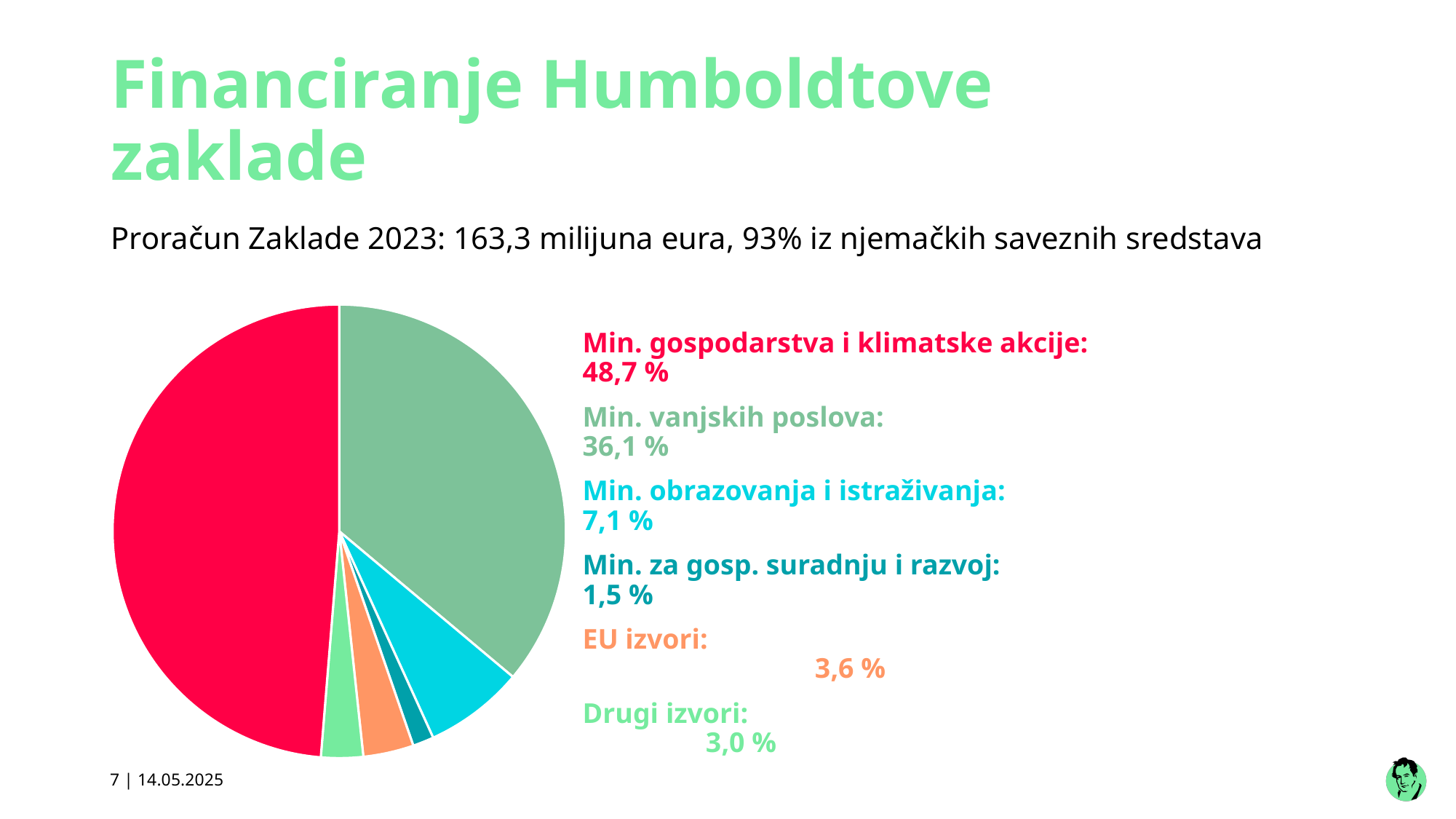
How many slices does the pie chart have? 6 What percentage is listed for Min. obrazovanja i istraživanja? 7,1 % What is the value for EU izvori? 3,6 % What share of the pie does Min. gospodarstva i klimatske akcije hold? 48,7 % Which category has the smallest slice of the pie? Min. za gosp. suradnju i razvoj What is the difference between the shares of Min. gospodarstva i klimatske akcije and Min. vanjskih poslova? 12,6 % What colour is the slice for Min. obrazovanja i istraživanja? Cyan Which is larger, the share for EU izvori or the share for Drugi izvori? EU izvori What type of chart is shown on the slide? Pie chart What is the value for Drugi izvori? 3,0 % What is the value shown for Min. vanjskih poslova? 36,1 % Which category has the largest slice of the pie? Min. gospodarstva i klimatske akcije